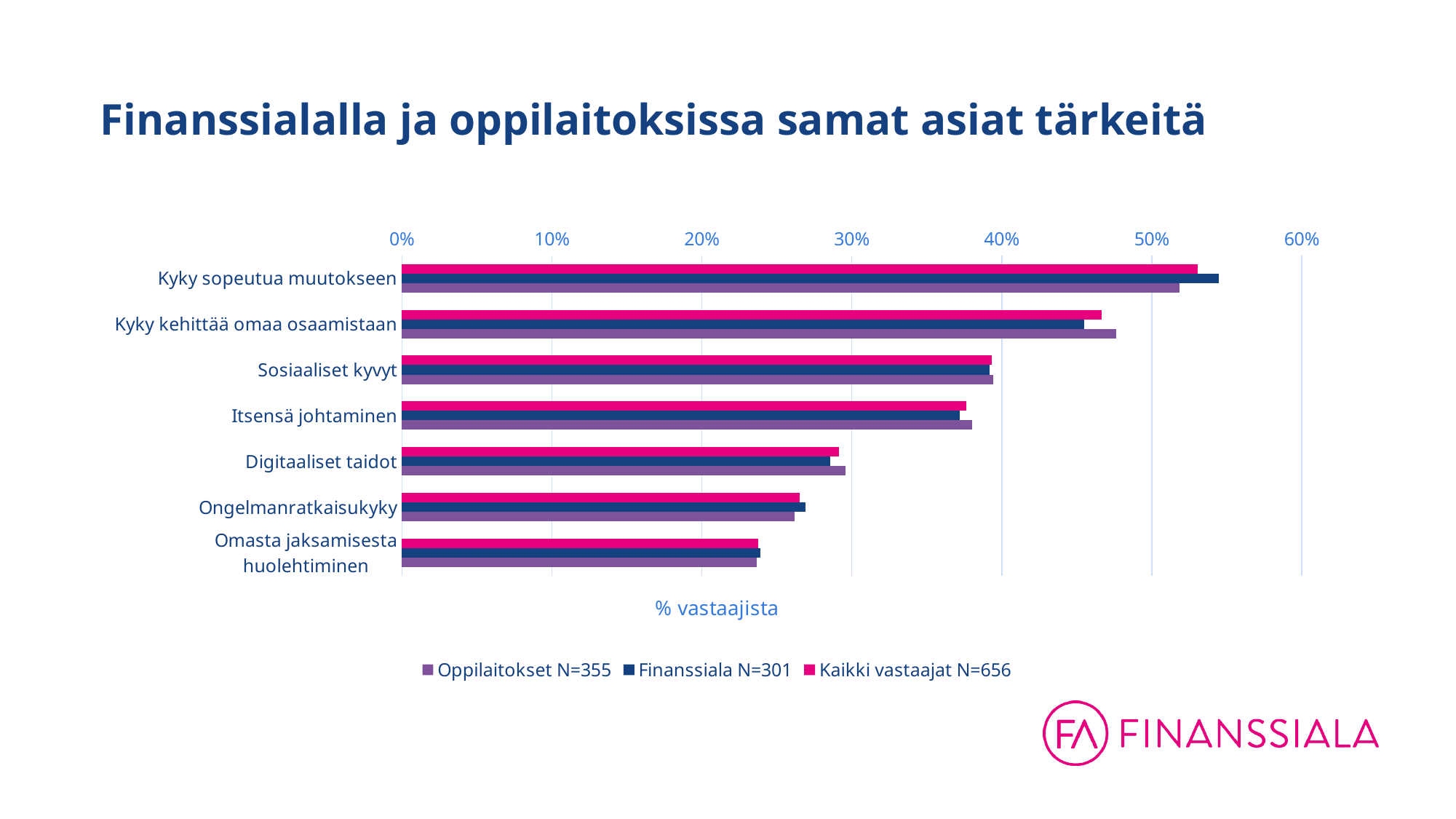
How many series does the legend list? 3 Is the Kaikki vastaajat N=656 value for Digitaaliset taidot greater or less than 30%? less Which category has the highest value for the Finanssiala N=301 series? Kyky sopeutua muutokseen What is the axis title shown below the chart? % vastaajista Which category has the lowest value for the Kaikki vastaajat N=656 series? Omasta jaksamisesta huolehtiminen How many categories are plotted on the chart? 7 What kind of chart is shown on the slide? bar chart Is the Oppilaitokset N=355 value for Itsensä johtaminen greater or less than 40%? less For Kyky kehittää omaa osaamistaan, which series has the larger value: Oppilaitokset N=355 or Finanssiala N=301? Oppilaitokset N=355 For Kyky sopeutua muutokseen, which series has the larger value: Finanssiala N=301 or Oppilaitokset N=355? Finanssiala N=301 Is the Oppilaitokset N=355 value for Ongelmanratkaisukyky greater or less than 20%? greater